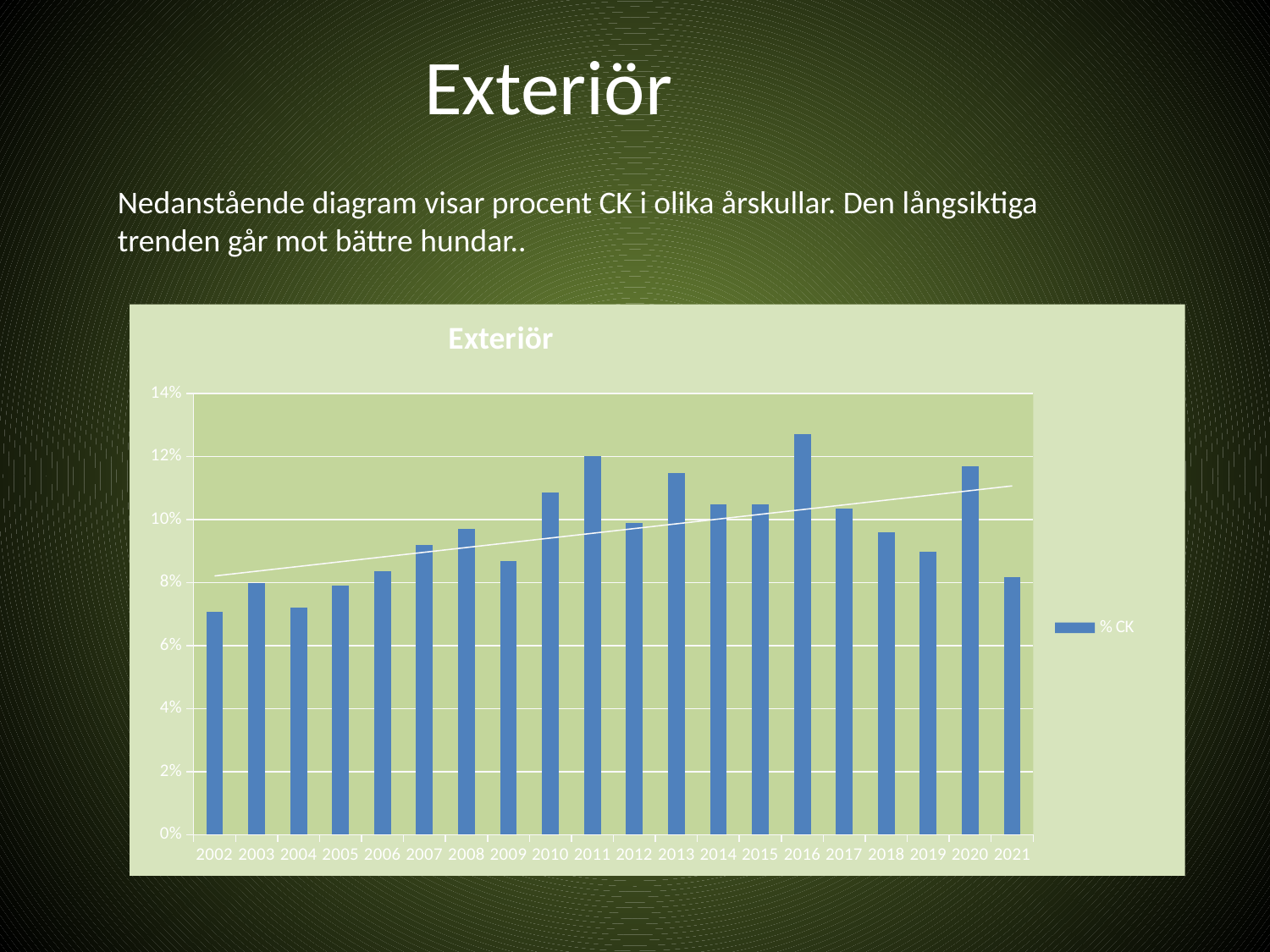
Is the value for 2016 greater or less than 12%? greater Is the value for 2021 greater or less than 10%? less What is the name of the series shown in the chart's legend? % CK Is the value for 2002 greater or less than 8%? less According to the trend line, do the % CK values generally rise or fall from 2002 to 2021? rise How many series does the chart's legend list? 1 Which year has the larger % CK value, 2011 or 2012? 2011 What is the title of the chart? Exteriör What kind of chart is shown on the slide? bar chart How many years (categories) are plotted on the x axis of the chart? 20 Which year has the highest % CK value in the chart? 2016